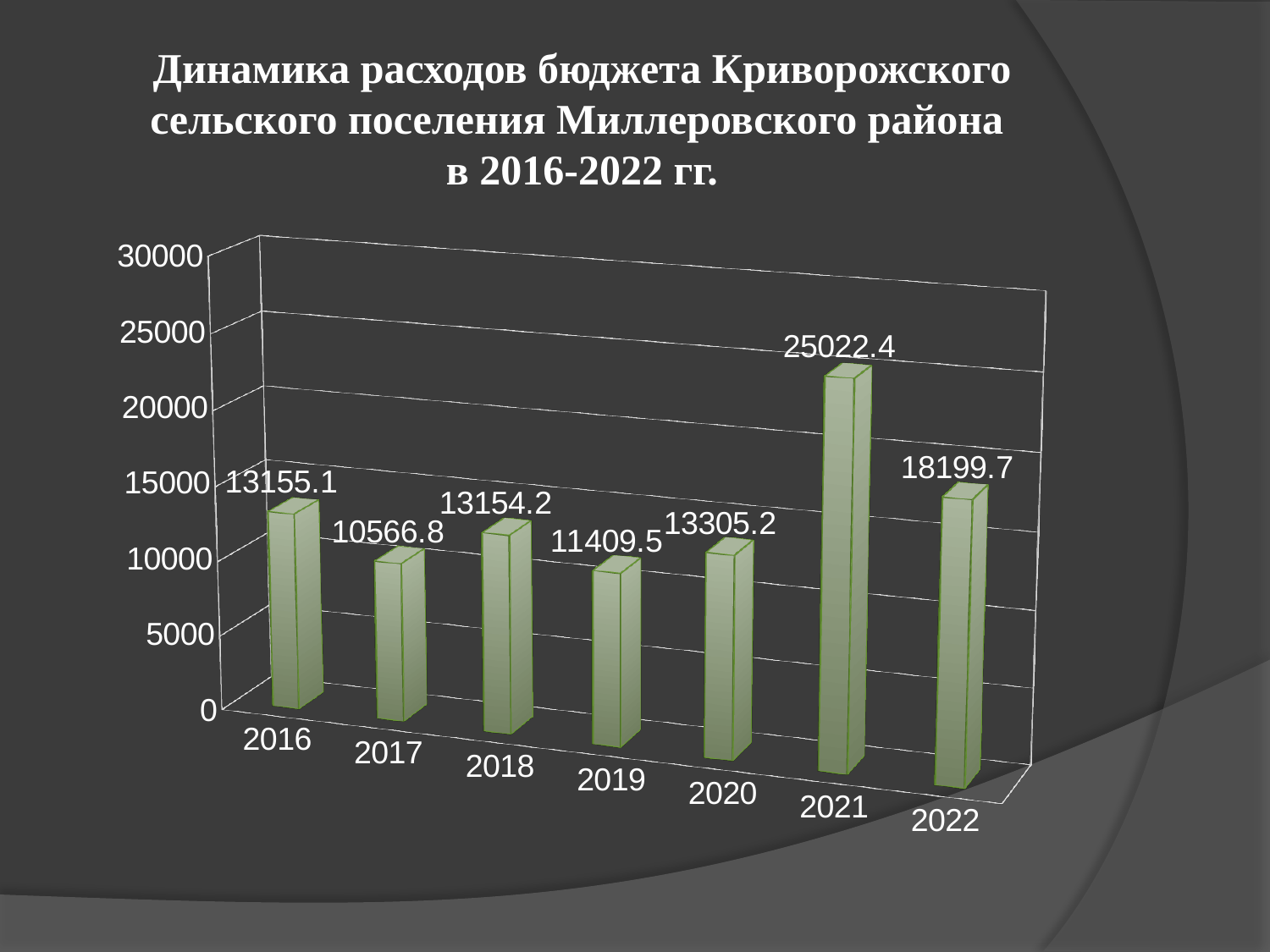
What is the value for 2017? 10566.8 How many years are shown on the x axis? 7 What is the difference between the values for 2020 and 2019? 1895.7 What is the value for 2021? 25022.4 What kind of chart is shown on the slide? bar chart What is the value for 2022? 18199.7 Which year has the highest value? 2021 Is the value for 2021 greater or less than 20000? greater What is the difference between the values for 2021 and 2022? 6822.7 Which is larger, the value for 2021 or the value for 2022? 2021 Which year has the lowest value? 2017 Does the value rise or fall from 2016 to 2017? fall